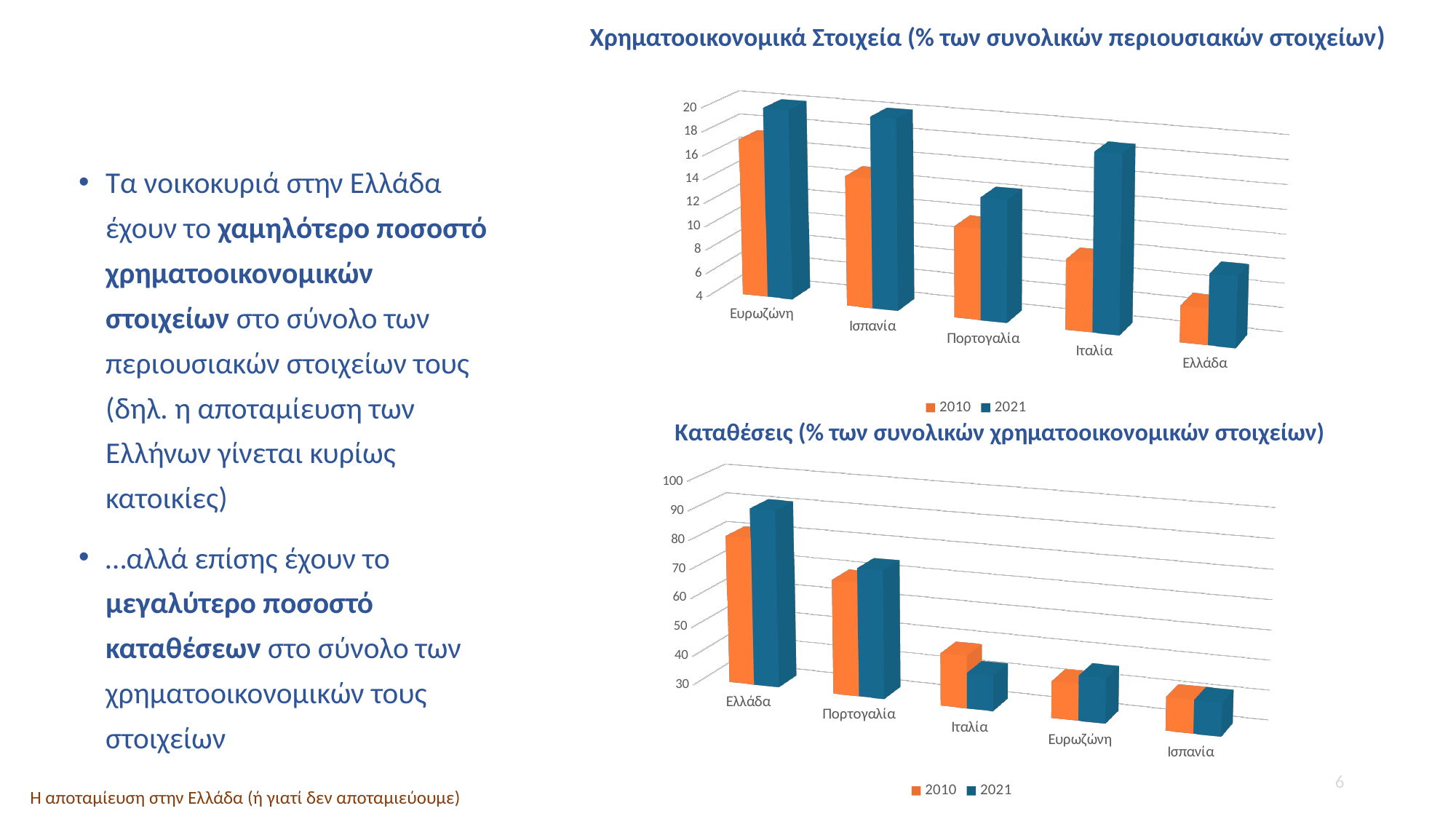
What are the two series listed in the legend of the top chart 'Χρηματοοικονομικά Στοιχεία'? 2010 and 2021 In the top chart 'Χρηματοοικονομικά Στοιχεία', which is larger for Ιταλία: the 2010 value or the 2021 value? 2021 In the top chart 'Χρηματοοικονομικά Στοιχεία', which category has the lowest value for 2021? Ελλάδα In the bottom chart 'Καταθέσεις', is the 2010 value for Ισπανία greater or less than 50? less In the top chart 'Χρηματοοικονομικά Στοιχεία', is the 2021 value for Ευρωζώνη greater or less than 14? greater In the top chart 'Χρηματοοικονομικά Στοιχεία', is the 2021 value for Ελλάδα greater or less than 10? less How many series does the legend of the bottom chart 'Καταθέσεις' list? 2 How many categories are shown on the x axis of the top chart 'Χρηματοοικονομικά Στοιχεία'? 5 What kind of chart is the top chart titled 'Χρηματοοικονομικά Στοιχεία (% των συνολικών περιουσιακών στοιχείων)'? Bar chart In the bottom chart 'Καταθέσεις', which category has the highest value for 2021? Ελλάδα In the bottom chart 'Καταθέσεις', which is larger for Ιταλία: the 2010 value or the 2021 value? 2010